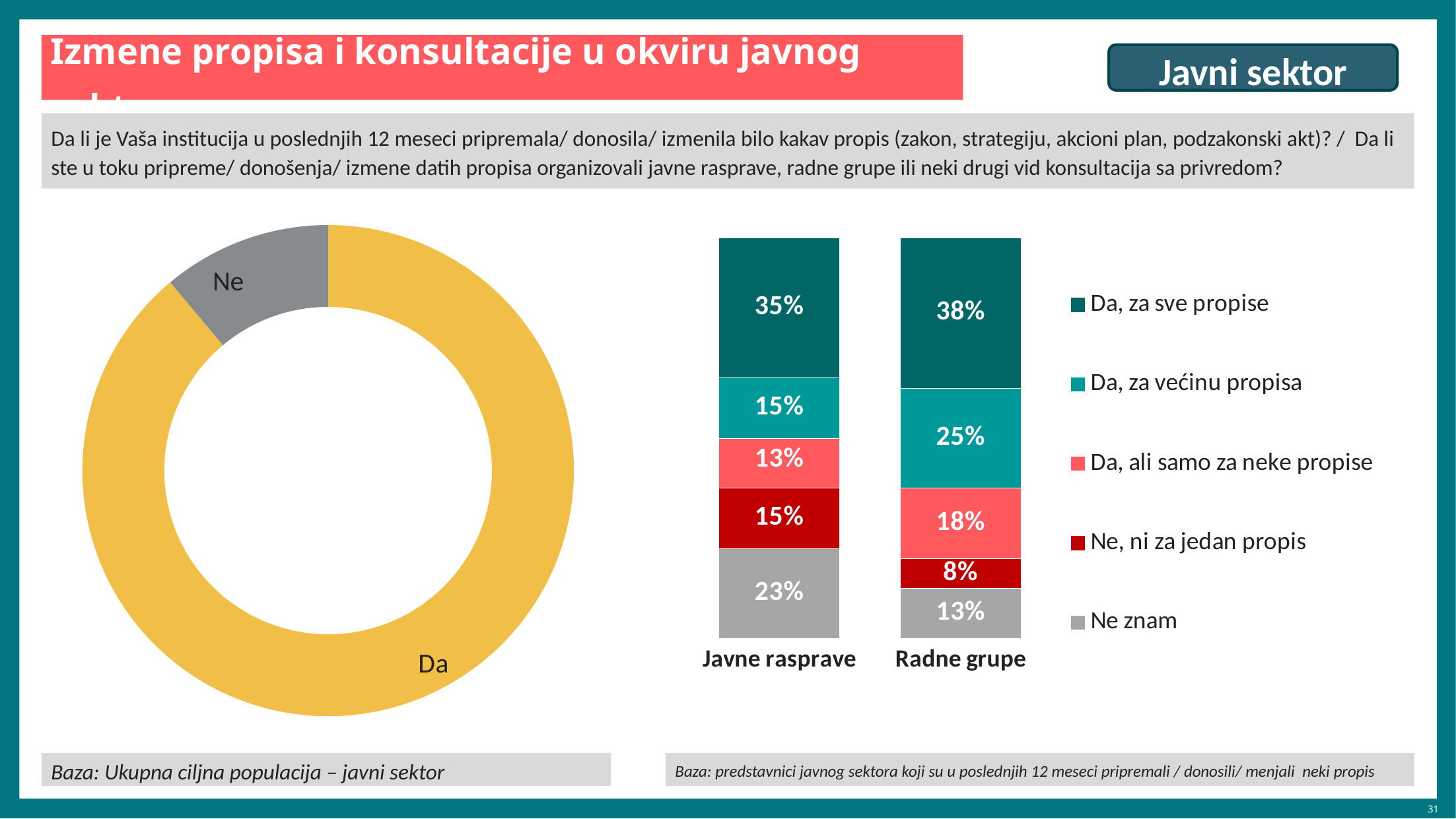
In the stacked bar chart on the right, which bar has the larger value for 'Ne znam': 'Javne rasprave' or 'Radne grupe'? Javne rasprave What kind of chart is shown on the left of the slide? Donut (pie) chart In the stacked bar chart on the right, what is the value for 'Ne, ni za jedan propis' in the 'Radne grupe' bar? 8% How many bars are in the stacked bar chart on the right? 2 In the stacked bar chart on the right, which segment is the largest in the 'Javne rasprave' bar? Da, za sve propise In the stacked bar chart on the right, what is the difference between 'Da, za većinu propisa' for 'Radne grupe' and for 'Javne rasprave'? 10% In the donut chart on the left, which slice is larger: 'Da' or 'Ne'? Da In the stacked bar chart on the right, what is the value for 'Da, za većinu propisa' in the 'Javne rasprave' bar? 15% In the stacked bar chart on the right, which segment is the smallest in the 'Radne grupe' bar? Ne, ni za jedan propis How many series does the legend of the stacked bar chart on the right list? 5 In the stacked bar chart on the right, what is the value for 'Da, za sve propise' in the 'Radne grupe' bar? 38% In the stacked bar chart on the right, what is the value for 'Ne znam' in the 'Javne rasprave' bar? 23%